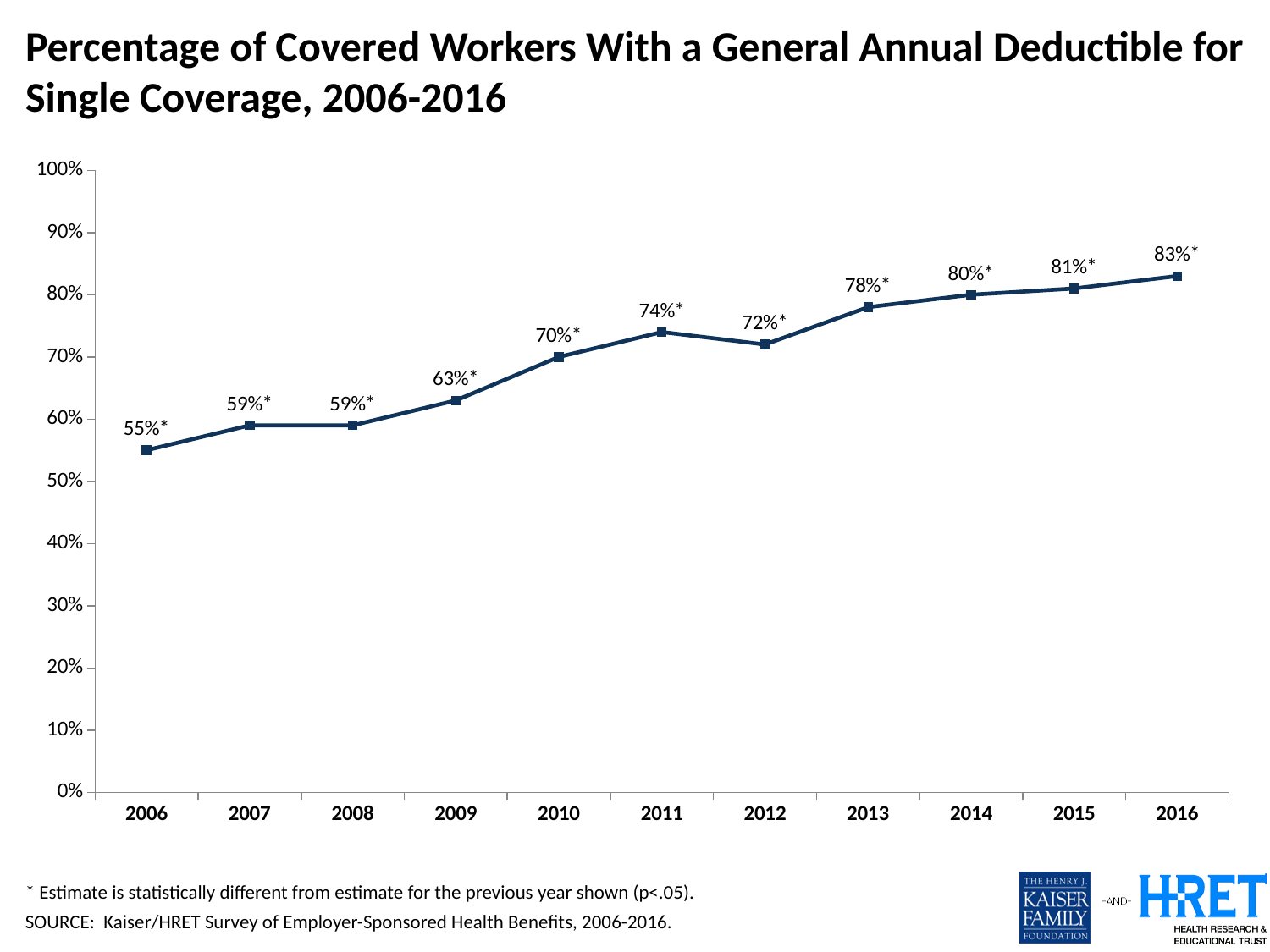
What is the value shown for 2016? 83% What is the overall trend of the values from 2006 to 2016? Rising Which year has a higher value, 2011 or 2012? 2011 What percentage of covered workers had a general annual deductible for single coverage in 2006? 55% Which year has the highest percentage of covered workers with a general annual deductible? 2016 Is the value for 2010 greater or less than 60%? greater By how many percentage points did the value change from 2006 to 2016? 28 percentage points What is the difference between the 2011 and 2012 values? 2 percentage points What kind of chart is shown on the slide? Line chart How many years are plotted on the chart? 11 Which year has the lowest percentage of covered workers with a general annual deductible? 2006 What is the value shown for 2012? 72%